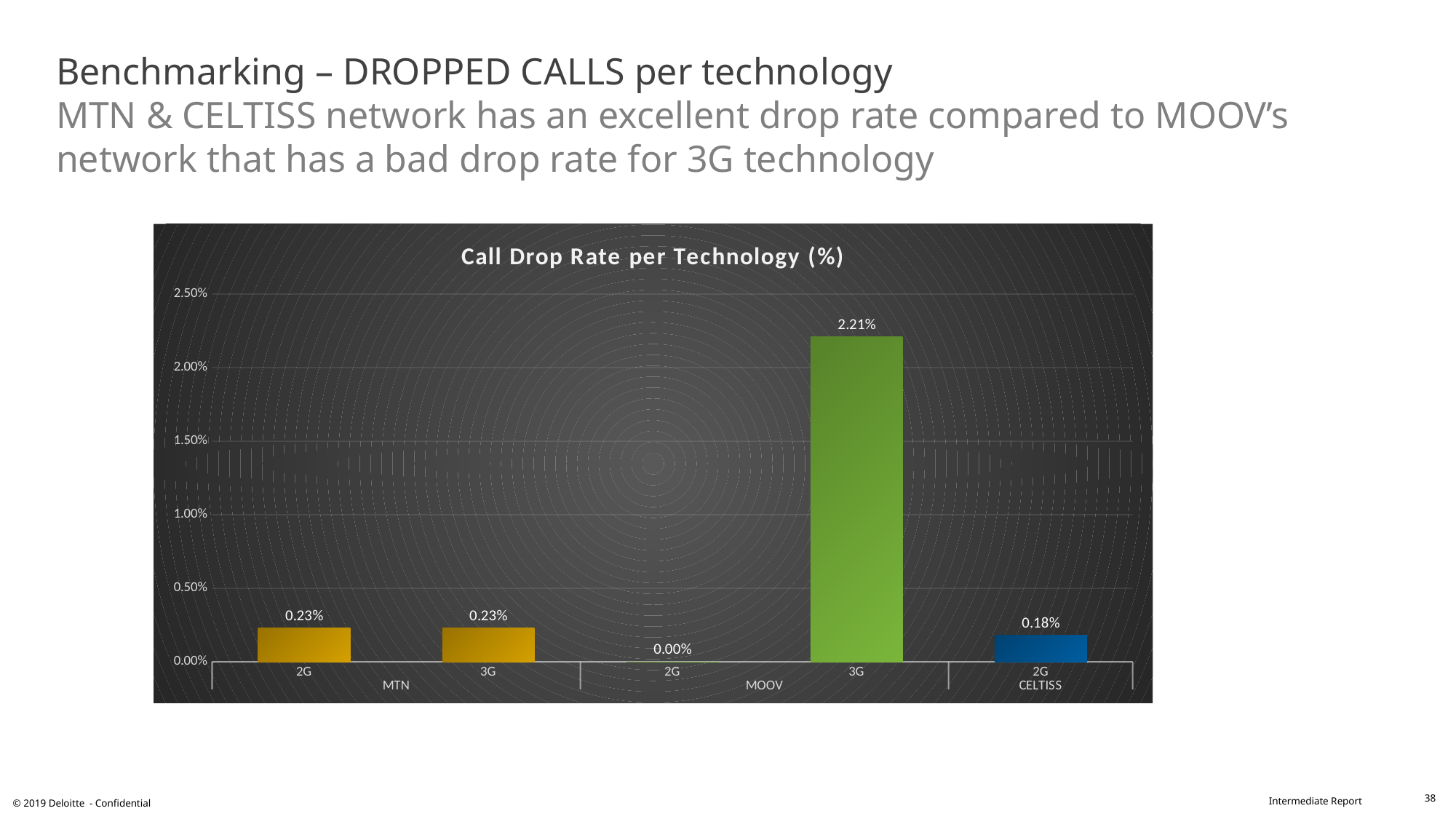
Which operator and technology has the lowest call drop rate? MOOV 2G What is the call drop rate for MOOV 2G? 0.00% What is the call drop rate for MOOV 3G? 2.21% What type of chart is shown on the slide? Bar chart Which operator and technology has the highest call drop rate? MOOV 3G What is the difference between the call drop rate of MOOV 3G and MTN 3G? 1.98% What is the call drop rate for MTN 2G? 0.23% How many bars (operator-technology combinations) are shown in the chart? 5 What is the title of the chart? Call Drop Rate per Technology (%) Is the call drop rate for MOOV 3G greater or less than 2.00%? greater Which has a higher call drop rate, MTN 2G or CELTISS 2G? MTN 2G What is the call drop rate for CELTISS 2G? 0.18%